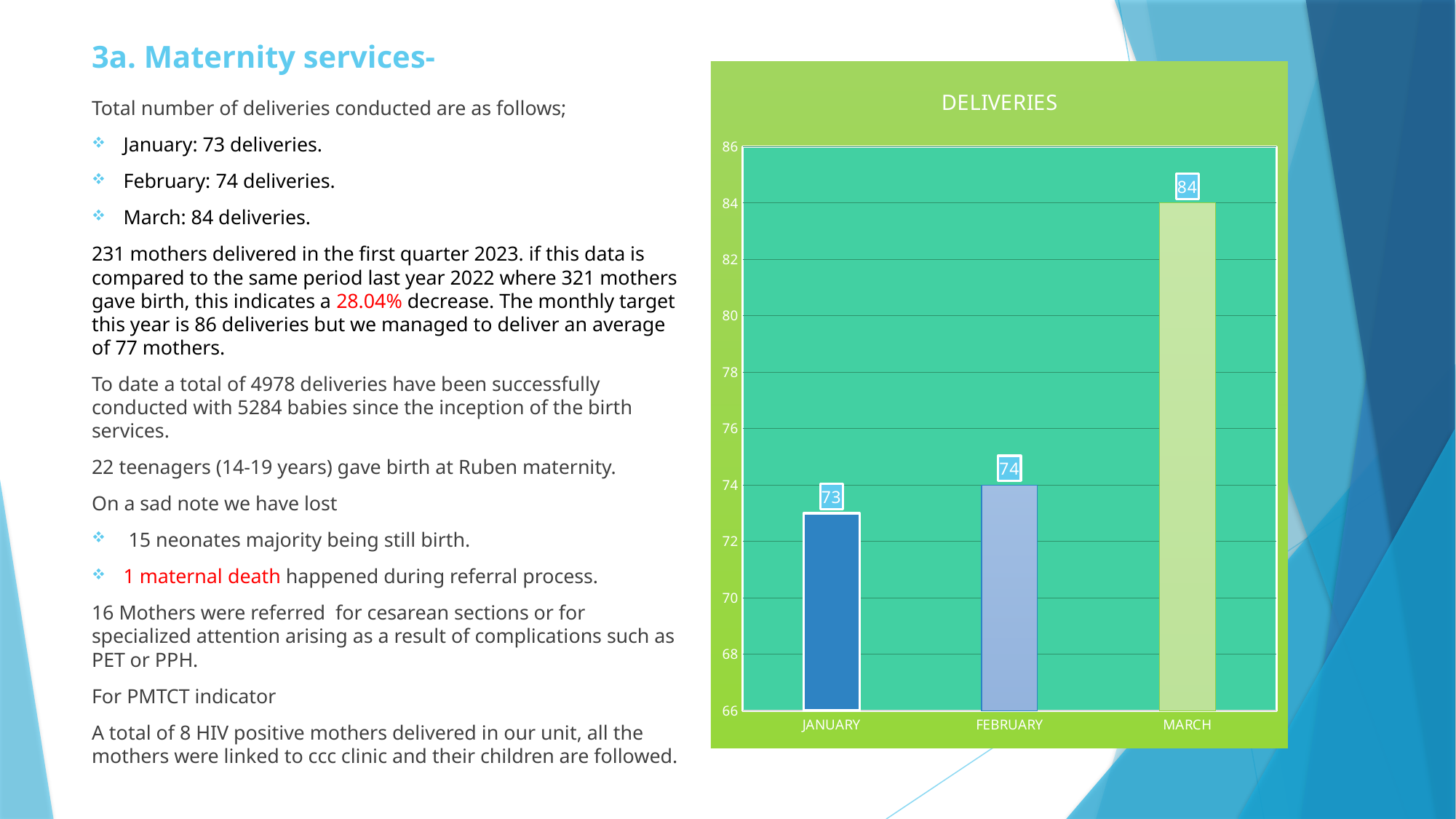
What is the difference between the FEBRUARY and JANUARY values in the DELIVERIES chart? 1 Which is larger in the DELIVERIES chart, the value for MARCH or the value for FEBRUARY? MARCH What is the value for JANUARY in the DELIVERIES chart? 73 What is the value for MARCH in the DELIVERIES chart? 84 How many categories are shown on the x axis of the DELIVERIES chart? 3 Which month has the highest number of deliveries in the chart? MARCH Which month has the lowest number of deliveries in the chart? JANUARY Is the value for MARCH in the DELIVERIES chart greater or less than 80? greater Do the values in the DELIVERIES chart rise or fall from JANUARY to MARCH? rise What is the value for FEBRUARY in the DELIVERIES chart? 74 What is the difference between the MARCH and JANUARY values in the DELIVERIES chart? 11 What kind of chart is the DELIVERIES chart? bar chart